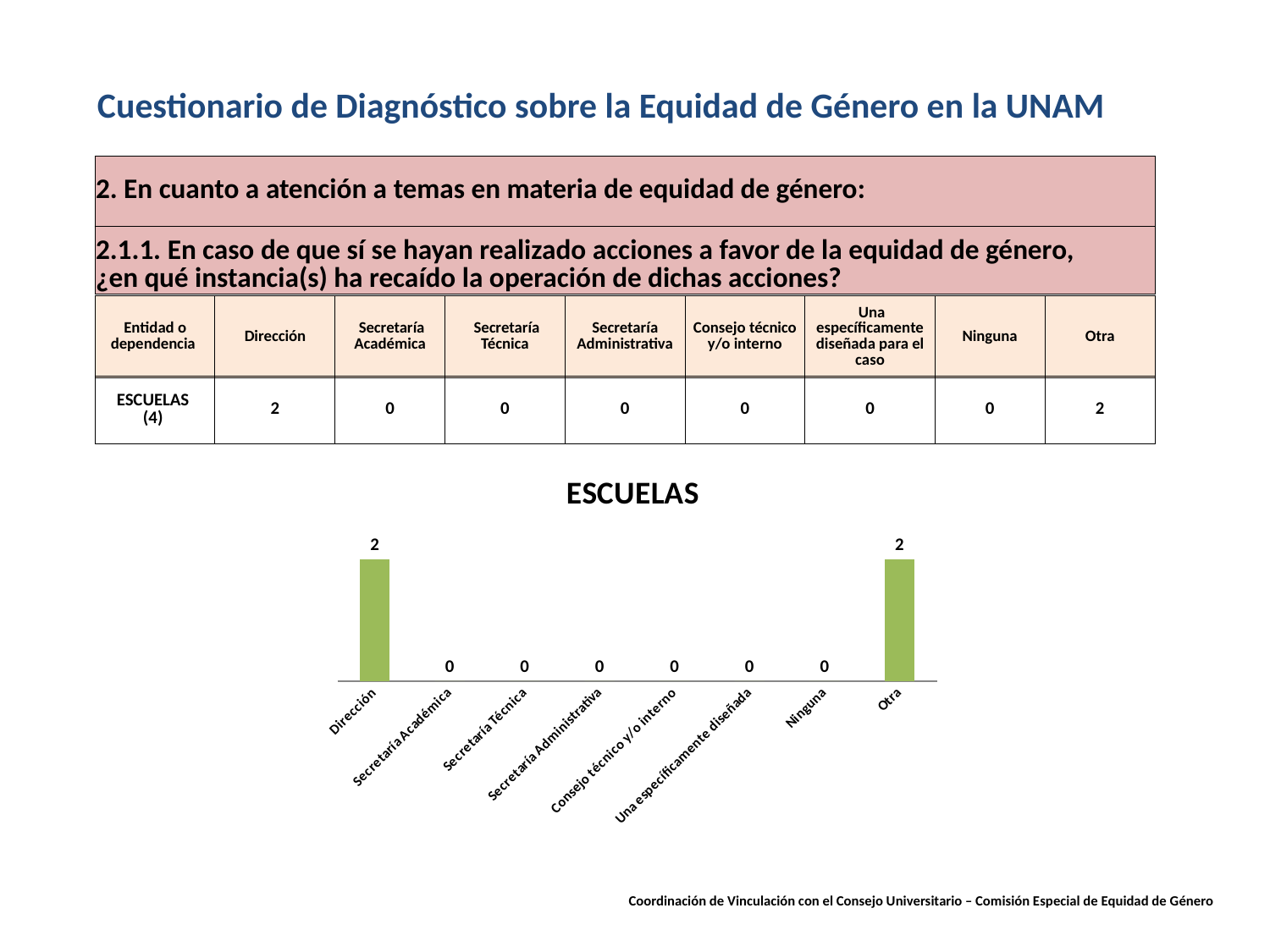
How many categories in the ESCUELAS chart have a value of 0? 6 What is the value for Otra in the ESCUELAS chart? 2 What is the value for Ninguna in the ESCUELAS chart? 0 What is the value for Secretaría Académica in the ESCUELAS chart? 0 What is the value for Consejo técnico y/o interno in the ESCUELAS chart? 0 Which is larger in the ESCUELAS chart, the value for Otra or the value for Ninguna? Otra What is the value for Dirección in the ESCUELAS chart? 2 What colour are the bars in the ESCUELAS chart? Green How many categories are shown on the x axis of the ESCUELAS chart? 8 What is the difference between the values for Dirección and Secretaría Técnica in the ESCUELAS chart? 2 What kind of chart is the ESCUELAS chart? Bar chart What is the title of the chart on the slide? ESCUELAS